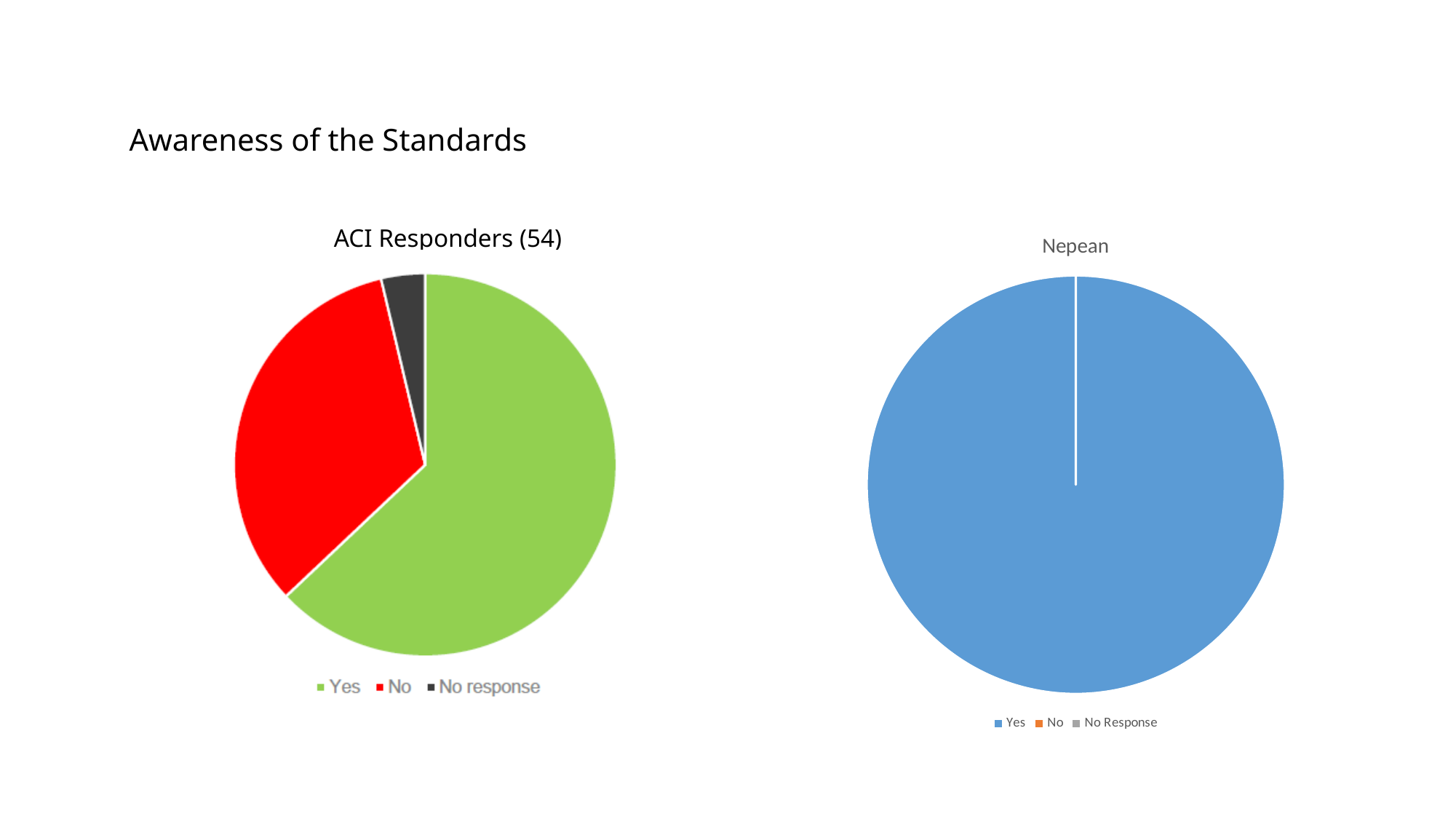
In the ACI Responders (54) chart, which category has the largest slice? Yes In the ACI Responders (54) chart, what colour is the No slice? red In the ACI Responders (54) chart, which slice is larger, Yes or No? Yes What kind of chart is the ACI Responders (54) chart? pie chart In the ACI Responders (54) chart, which category has the smallest slice? No response What kind of chart is the Nepean chart? pie chart How many pie charts are shown on the slide? 2 How many categories does the legend of the Nepean chart list? 3 What is the title of the chart on the left of the slide? ACI Responders (54) In the Nepean chart, which category has the largest slice? Yes How many categories does the legend of the ACI Responders (54) chart list? 3 In the ACI Responders (54) chart, which slice is larger, No or No response? No